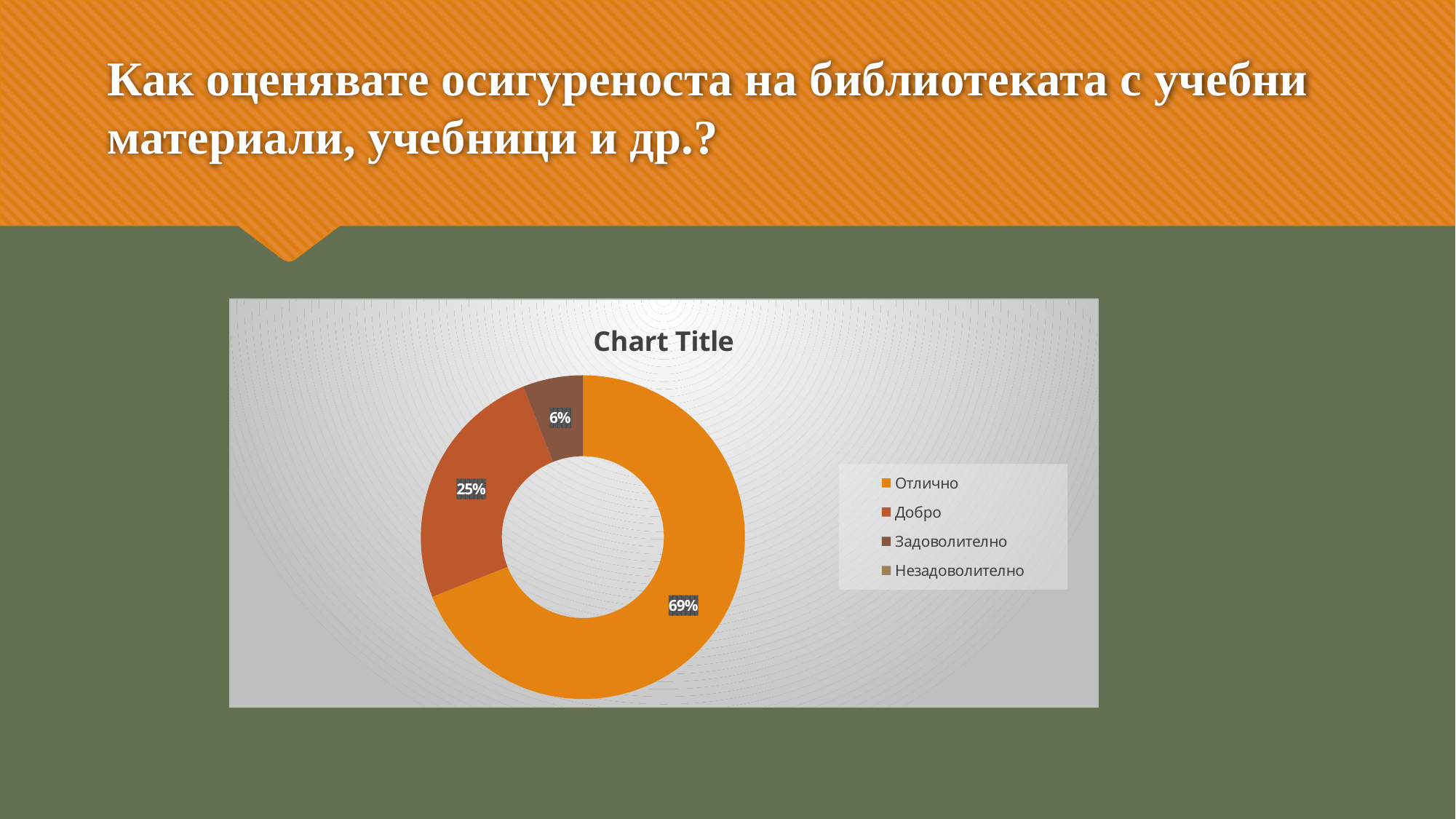
What is the difference between the shares of Отлично and Добро? 44% What share of the chart does Задоволително have? 6% How many entries does the legend list? 4 Which is larger, the share for Добро or the share for Задоволително? Добро Which category has the largest share of the chart? Отлично What is the difference between the shares of Добро and Задоволително? 19% What kind of chart is shown on the slide? doughnut chart Which legend entry is shown in orange? Отлично What share of the chart does Отлично have? 69% What share of the chart does Добро have? 25% What is the title of the chart? Chart Title Which of the labelled slices has the smallest share? Задоволително